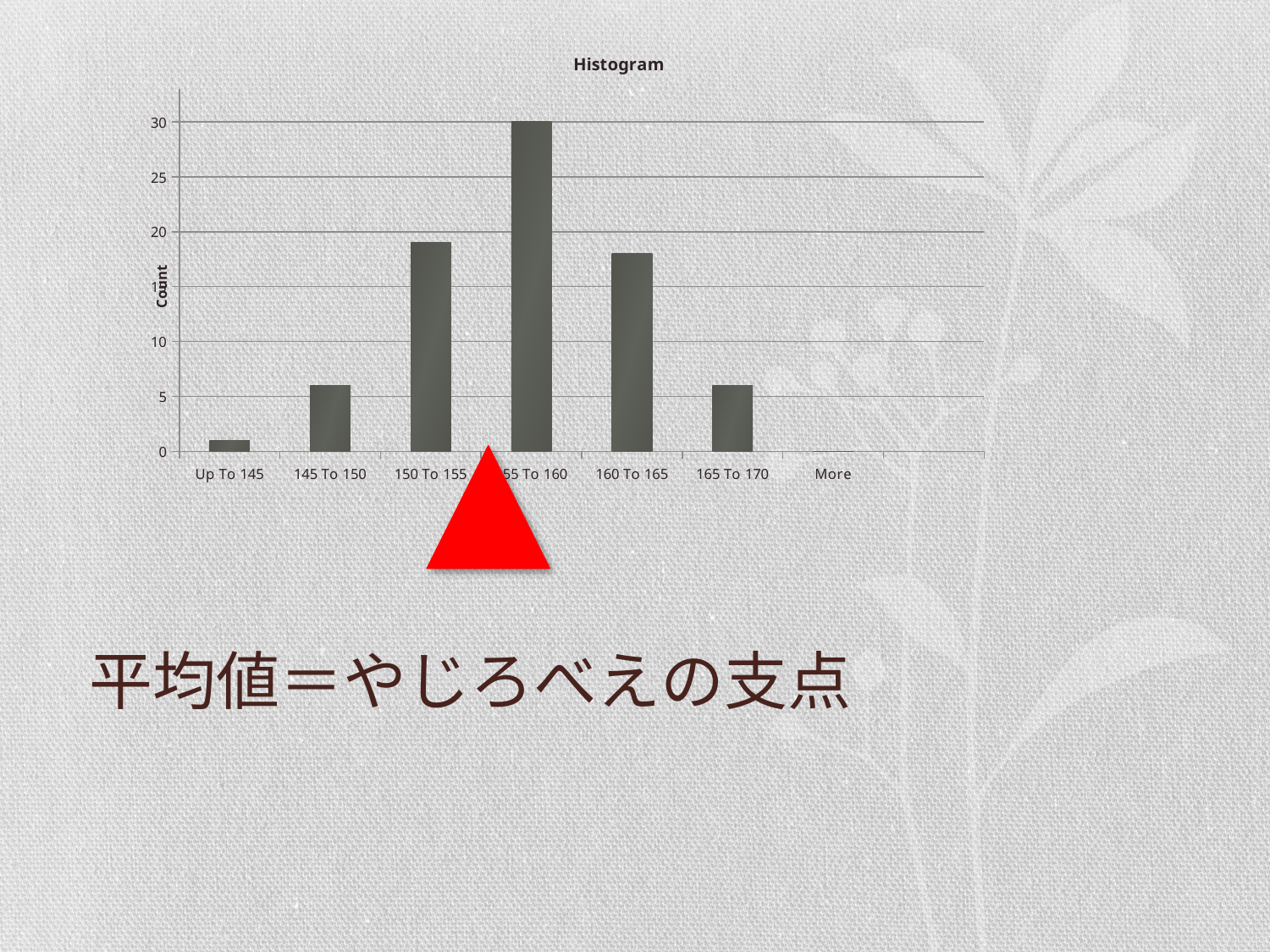
What kind of chart is shown on the slide? bar chart Is the value for 145 To 150 greater or less than 5? greater What is the value of the tallest bar in the chart? 30 Is the value for 150 To 155 greater or less than 15? greater How many categories are shown on the x axis? 7 Is the value for 160 To 165 greater or less than 15? greater What is the title of the chart? Histogram What is the label of the vertical axis? Count Which has the larger value, 150 To 155 or 145 To 150? 150 To 155 Which has the larger value, 160 To 165 or 165 To 170? 160 To 165